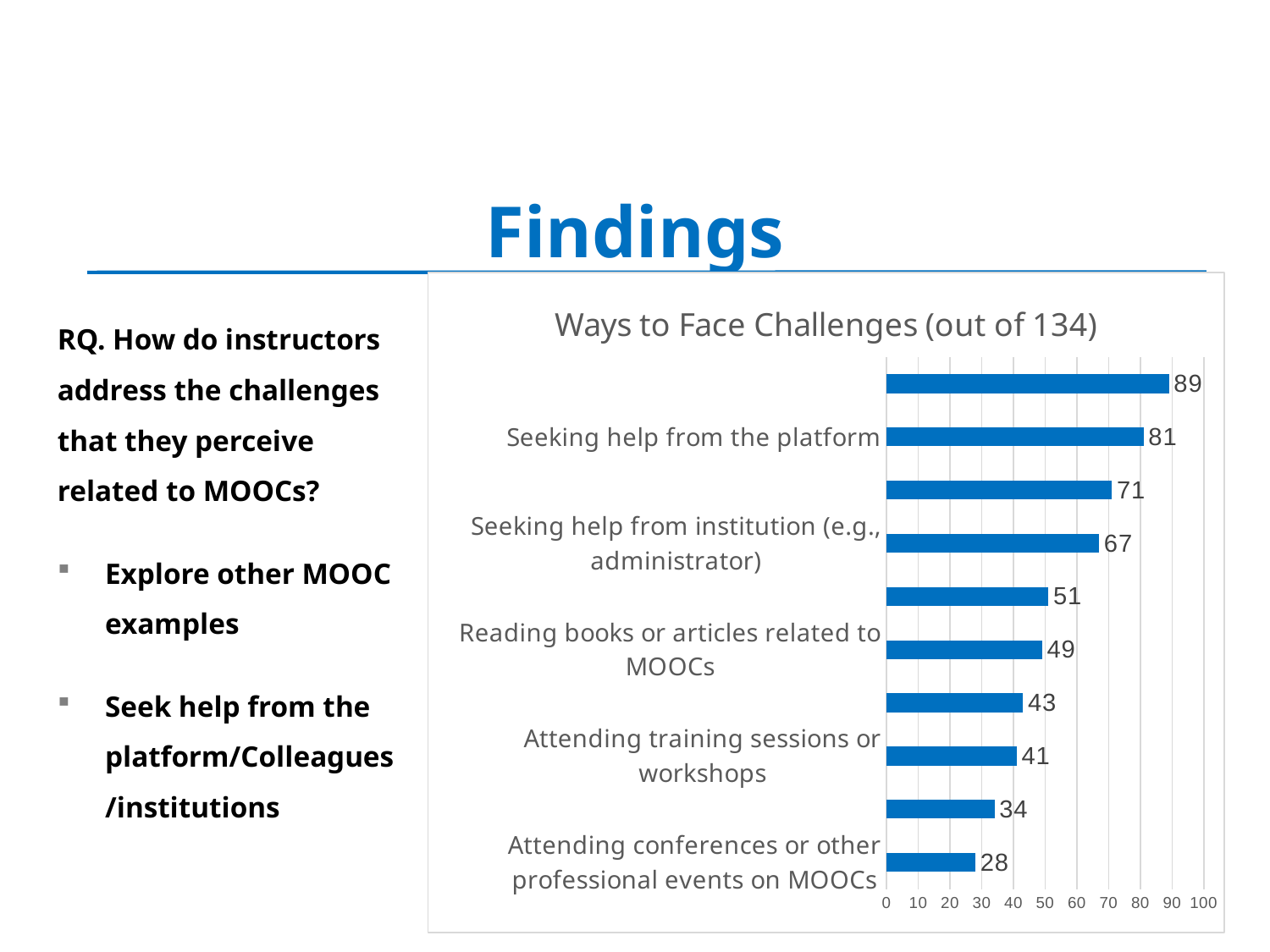
What is the value for "Attending training sessions or workshops"? 41 What is the title of the chart? Ways to Face Challenges (out of 134) What is the value for "Seeking help from institution (e.g., administrator)"? 67 What is the value for "Reading books or articles related to MOOCs"? 49 What is the value for "Seeking help from the platform"? 81 Which is larger: the value for "Reading books or articles related to MOOCs" or for "Attending training sessions or workshops"? Reading books or articles related to MOOCs Which labeled category has the lowest value? Attending conferences or other professional events on MOOCs What kind of chart is shown on the slide? Bar chart What is the difference between the values for "Seeking help from the platform" and "Seeking help from institution (e.g., administrator)"? 14 What is the largest value shown on the chart? 89 How many bars are plotted on the chart? 10 What is the value for "Attending conferences or other professional events on MOOCs"? 28